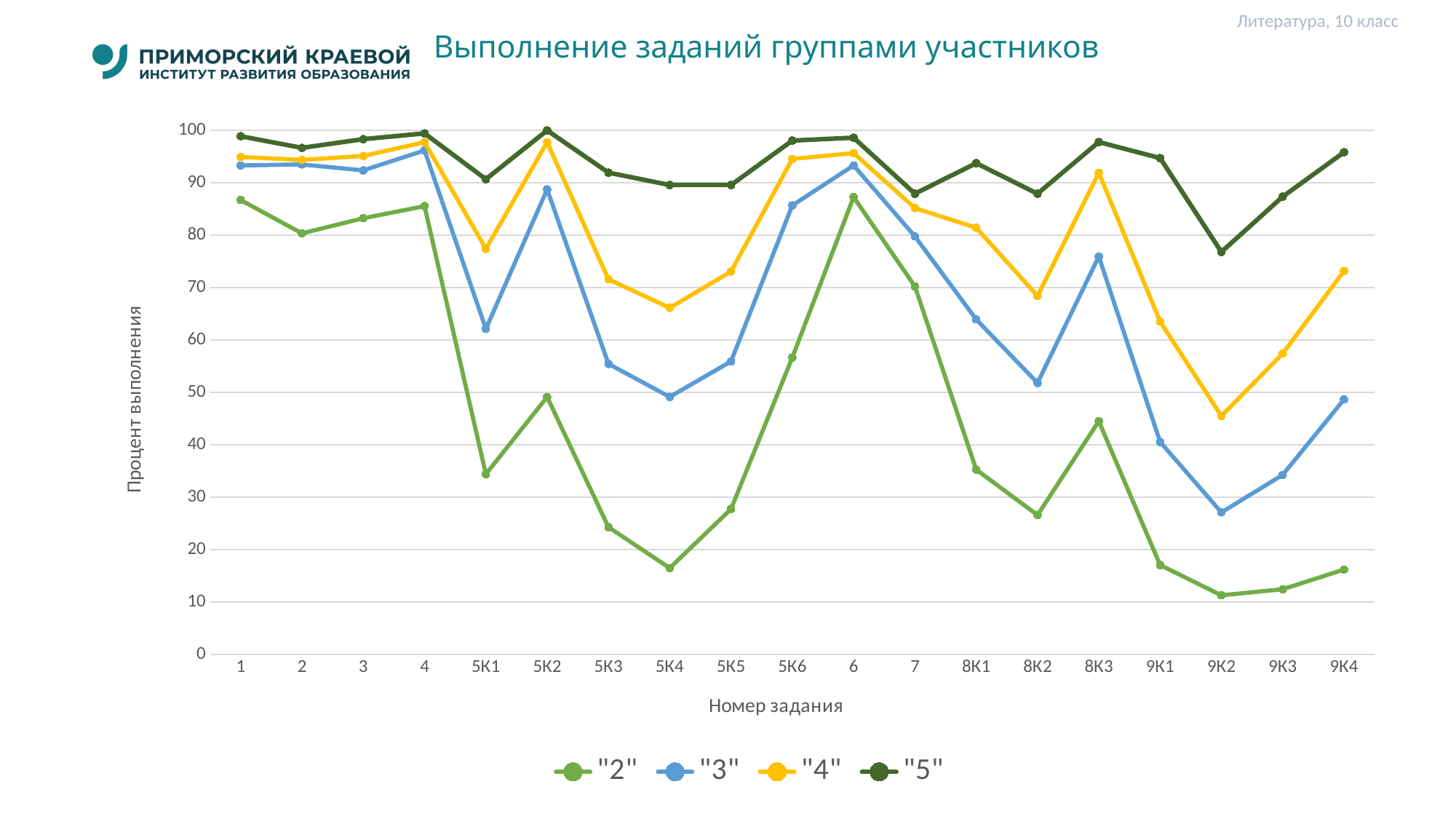
Does the value of series "4" rise or fall from task 9К2 to task 9К4? rise At task 5К2, which series has the higher value, "3" or "4"? "4" For which task is the value of series "5" the lowest? 9К2 Is the value for series "2" at task 5К4 greater or less than 20? less What kind of chart is shown on the slide? line chart How many tasks (categories) are plotted along the x axis? 19 Is the value for series "3" at task 9К2 greater or less than 30? less For which task is the value of series "3" the lowest? 9К2 Is the value for series "4" at task 9К2 greater or less than 50? less What is the title of the vertical axis? Процент выполнения How many series does the legend list? 4